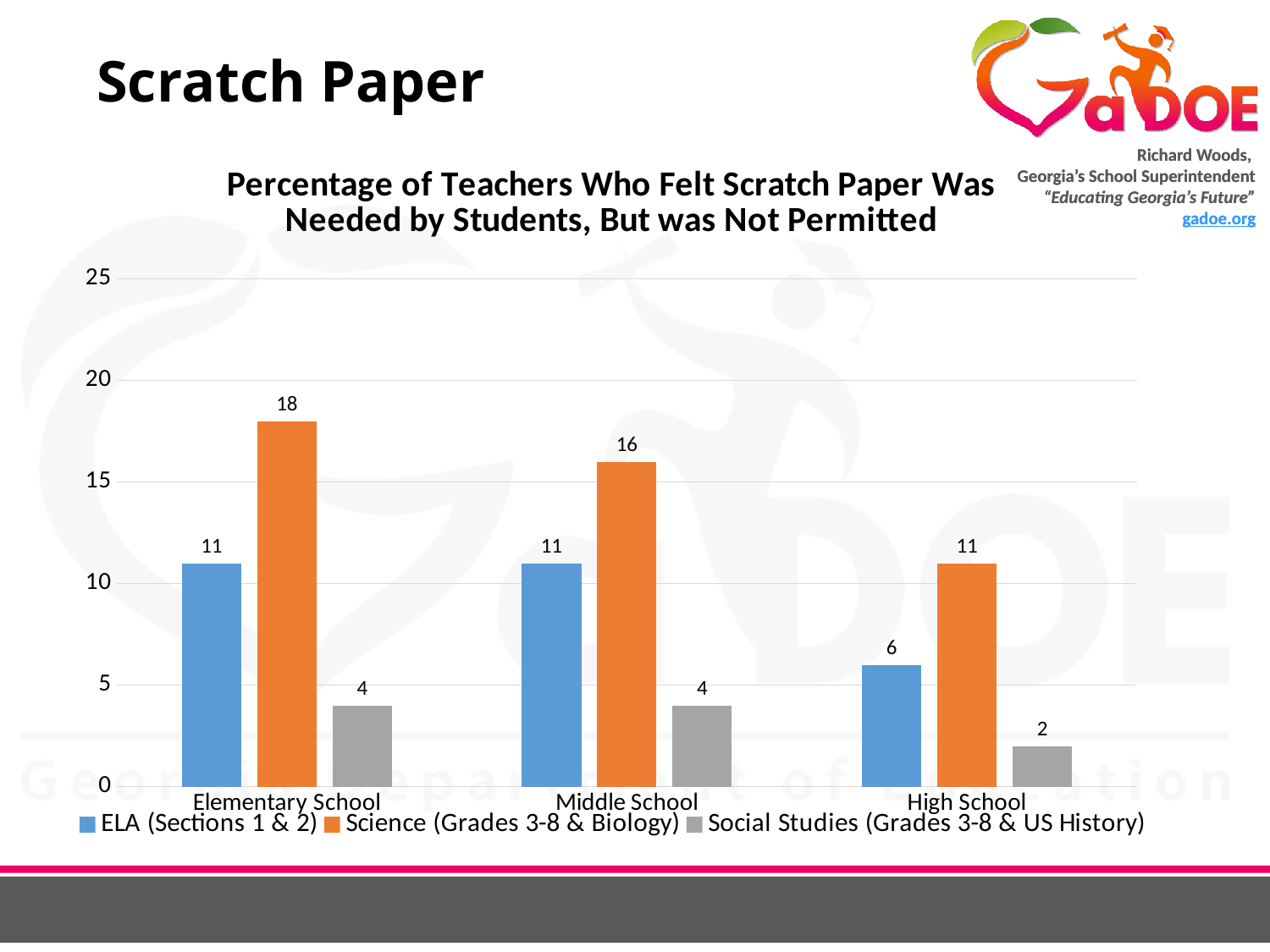
Do the Science (Grades 3-8 & Biology) values rise or fall from Elementary School to High School? Fall What is the difference between the Science and ELA values at Middle School? 5 What kind of chart is shown on the slide? Bar chart Which school level has the lowest value for Social Studies (Grades 3-8 & US History)? High School How many school levels are shown on the x axis? 3 Which school level has the highest value for Science (Grades 3-8 & Biology)? Elementary School What is the value for Science (Grades 3-8 & Biology) at Elementary School? 18 What is the value for Social Studies (Grades 3-8 & US History) at Middle School? 4 Is the value for Science at Elementary School greater or less than 15? greater What is the value for ELA (Sections 1 & 2) at High School? 6 How many series does the legend list? 3 Which is larger at High School: the ELA value or the Science value? Science (Grades 3-8 & Biology)